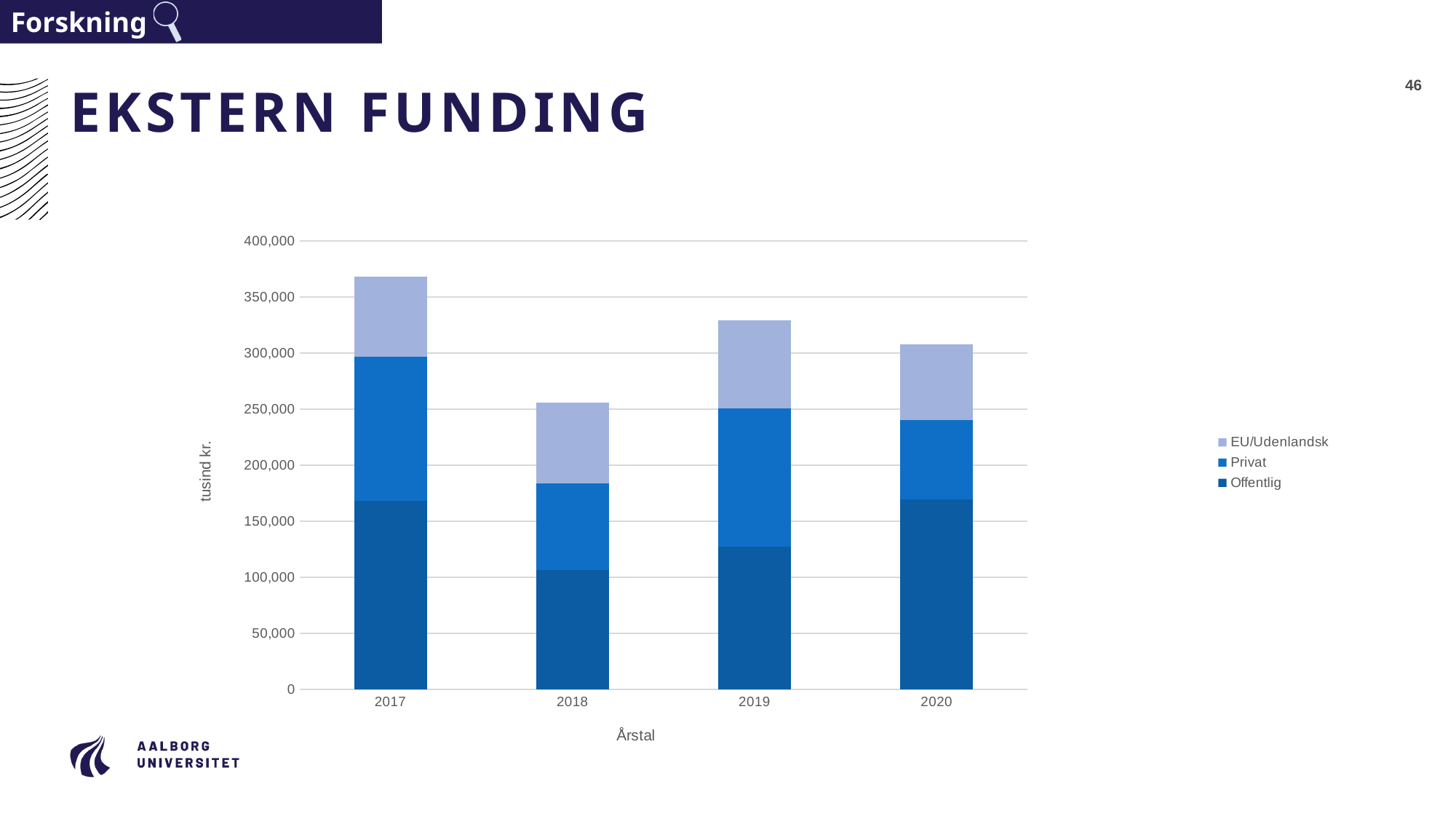
Which year has the lowest Offentlig funding? 2018 What kind of chart is shown on the slide? Stacked bar chart How many years are shown on the x axis of the chart? 4 Is the total funding for 2018 greater or less than 300,000? less Which year has the highest total external funding? 2017 What is the label on the y axis of the chart? tusind kr. Which year has the lowest total external funding? 2018 Does the total funding rise or fall from 2017 to 2018? fall How many series does the chart's legend list? 3 Is the total funding for 2017 greater or less than 350,000? greater Which year has the larger total funding, 2019 or 2020? 2019 Is the Offentlig value for 2019 greater or less than 150,000? less